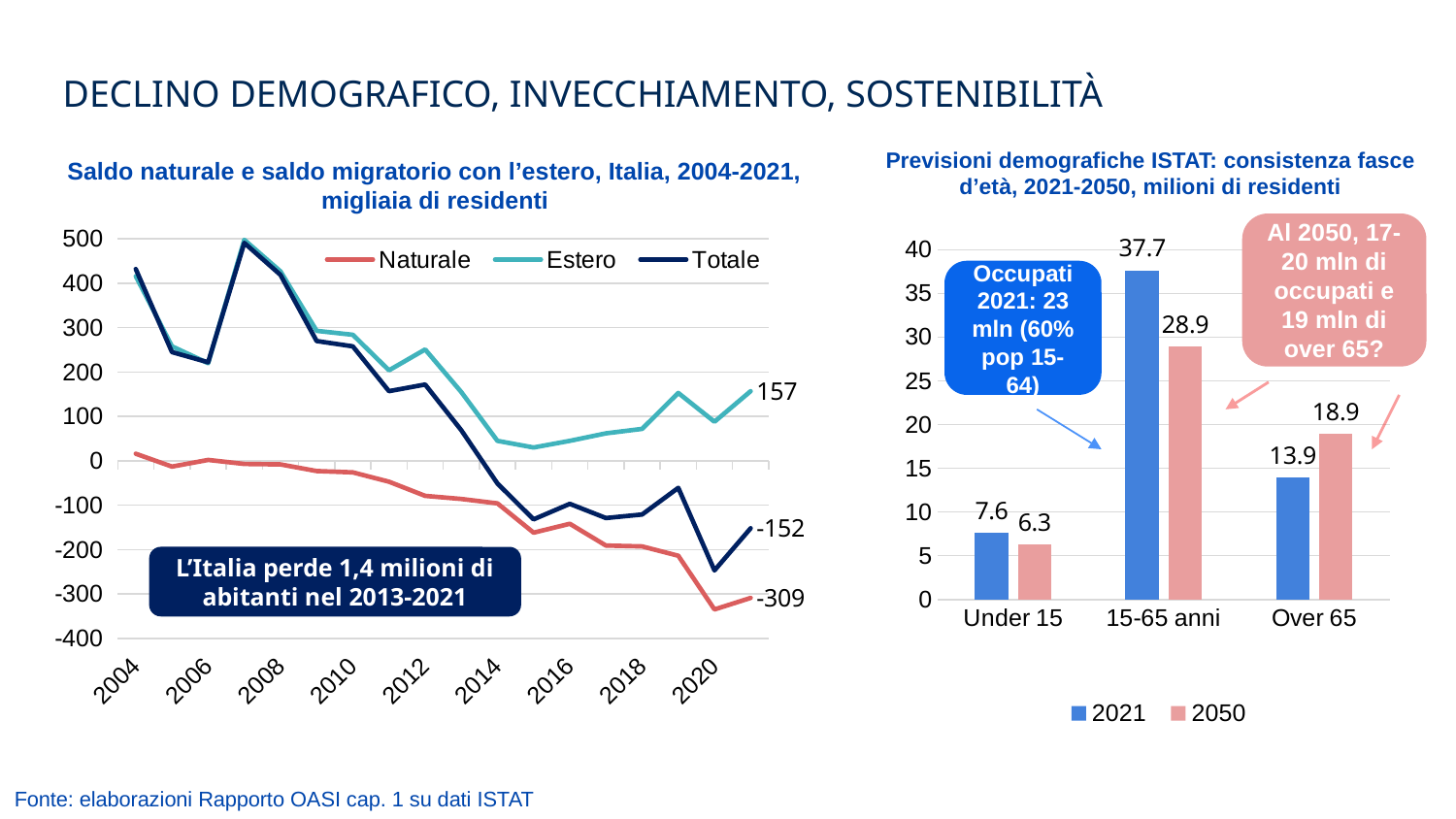
In the chart 'Saldo naturale e saldo migratorio con l'estero', what is the final labelled value of the 'Naturale' series? -309 How many series does the legend of the chart 'Previsioni demografiche ISTAT' list? 2 In the chart 'Previsioni demografiche ISTAT', which age group has the lowest value in 2050? Under 15 In the chart 'Previsioni demografiche ISTAT', what is the value for '15-65 anni' in 2021? 37.7 In the chart 'Saldo naturale e saldo migratorio con l'estero', what is the final labelled value of the 'Estero' series? 157 In the chart 'Saldo naturale e saldo migratorio con l'estero', does the 'Naturale' series rise or fall from 2004 to 2021? Fall In the chart 'Previsioni demografiche ISTAT', is the 2021 value or the 2050 value larger for 'Over 65'? 2050 In the chart 'Previsioni demografiche ISTAT', what is the value for 'Over 65' in 2050? 18.9 In the chart 'Previsioni demografiche ISTAT', what is the difference between the 2021 and 2050 values for '15-65 anni'? 8.8 In the chart 'Previsioni demografiche ISTAT', what is the value for 'Under 15' in 2050? 6.3 What kind of chart is the chart 'Previsioni demografiche ISTAT'? Bar chart In the chart 'Previsioni demografiche ISTAT', which age group has the highest value in 2021? 15-65 anni